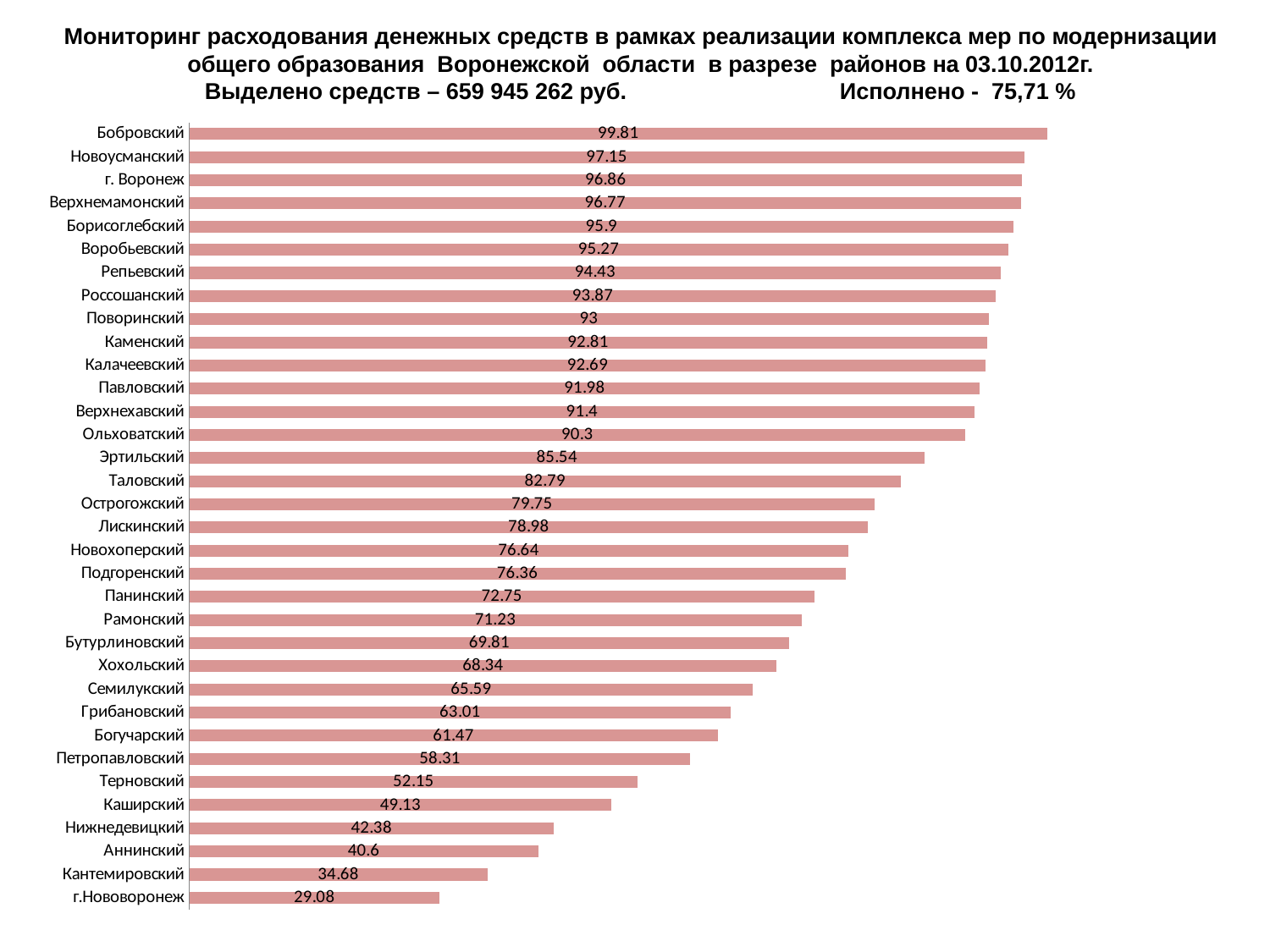
What kind of chart is shown on the slide? Bar chart What is the value shown for Бобровский? 99.81 What is the difference between the values for Бобровский and г.Нововоронеж? 70.73 Which district has the highest value on the chart? Бобровский What is the difference between the values for Поворинский and Эртильский? 7.46 Do the values rise or fall going from the top bar to the bottom bar? Fall What is the value shown for г. Воронеж? 96.86 What is the value shown for Таловский? 82.79 How many districts are shown on the chart? 34 Which has a larger value, Терновский or Каширский? Терновский Which category has the lowest value on the chart? г.Нововоронеж What is the value shown for Кантемировский? 34.68